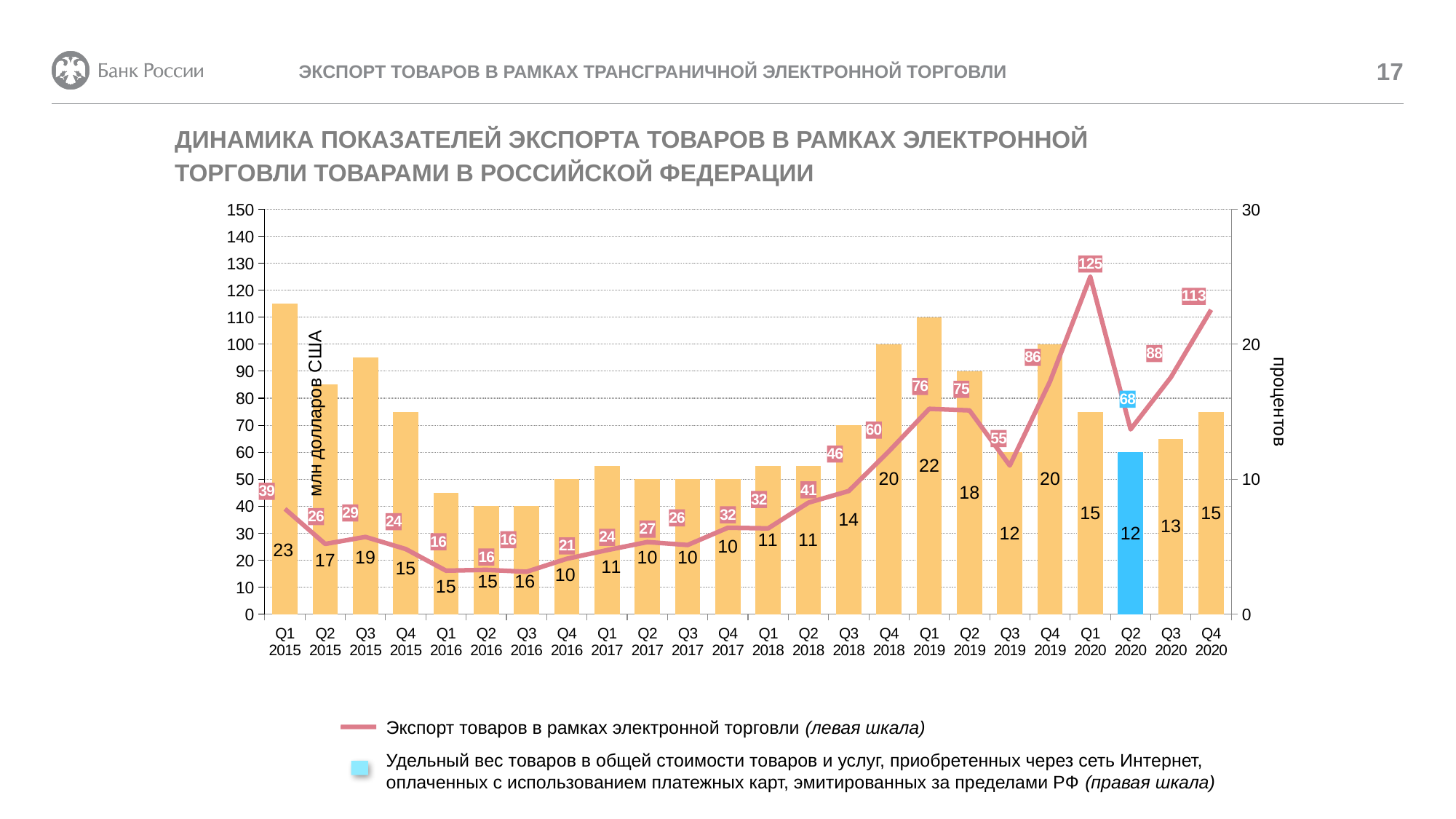
What is the unit label on the right axis? процентов In which quarter does the export line reach its highest value? Q1 2020 What is the export value (line) for Q4 2020? 113 Which is larger, the export line value for Q3 2019 or for Q4 2019? Q4 2019 Is the export line value for Q4 2018 greater or less than 50 on the left scale? greater How many quarters are shown on the x axis? 24 What is the difference between the export line values for Q1 2020 and Q2 2020? 57 Which quarter has the highest bar value? Q1 2015 What is the bar value (share, right scale) for Q1 2019? 22 What is the export value (line, left scale) for Q1 2020? 125 How many series does the legend list? 2 What is the bar value for Q2 2020, the bar highlighted in blue? 12